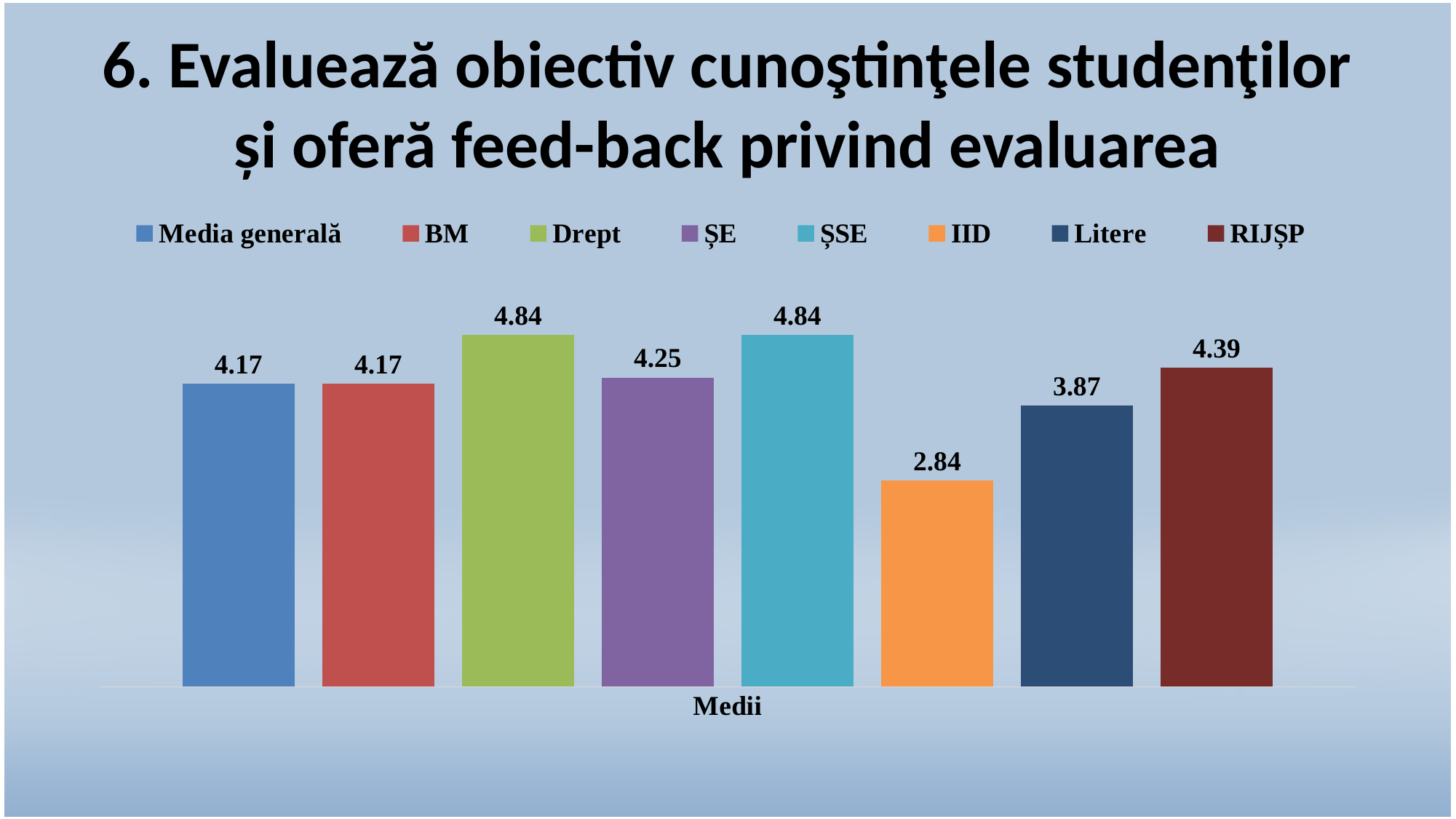
Which two series share the highest value of 4.84? Drept and ȘSE How many series does the legend list? 8 What is the difference between the values for RIJȘP and Litere? 0.52 What is the value for RIJȘP? 4.39 What is the value for Media generală? 4.17 What is the value for ȘE? 4.25 What is the value for IID? 2.84 Which is larger, the value for ȘE or the value for BM? ȘE What is the value for Litere? 3.87 What kind of chart is shown on the slide? Bar chart What is the difference between the values for Drept and IID? 2 Which series has the lowest value? IID